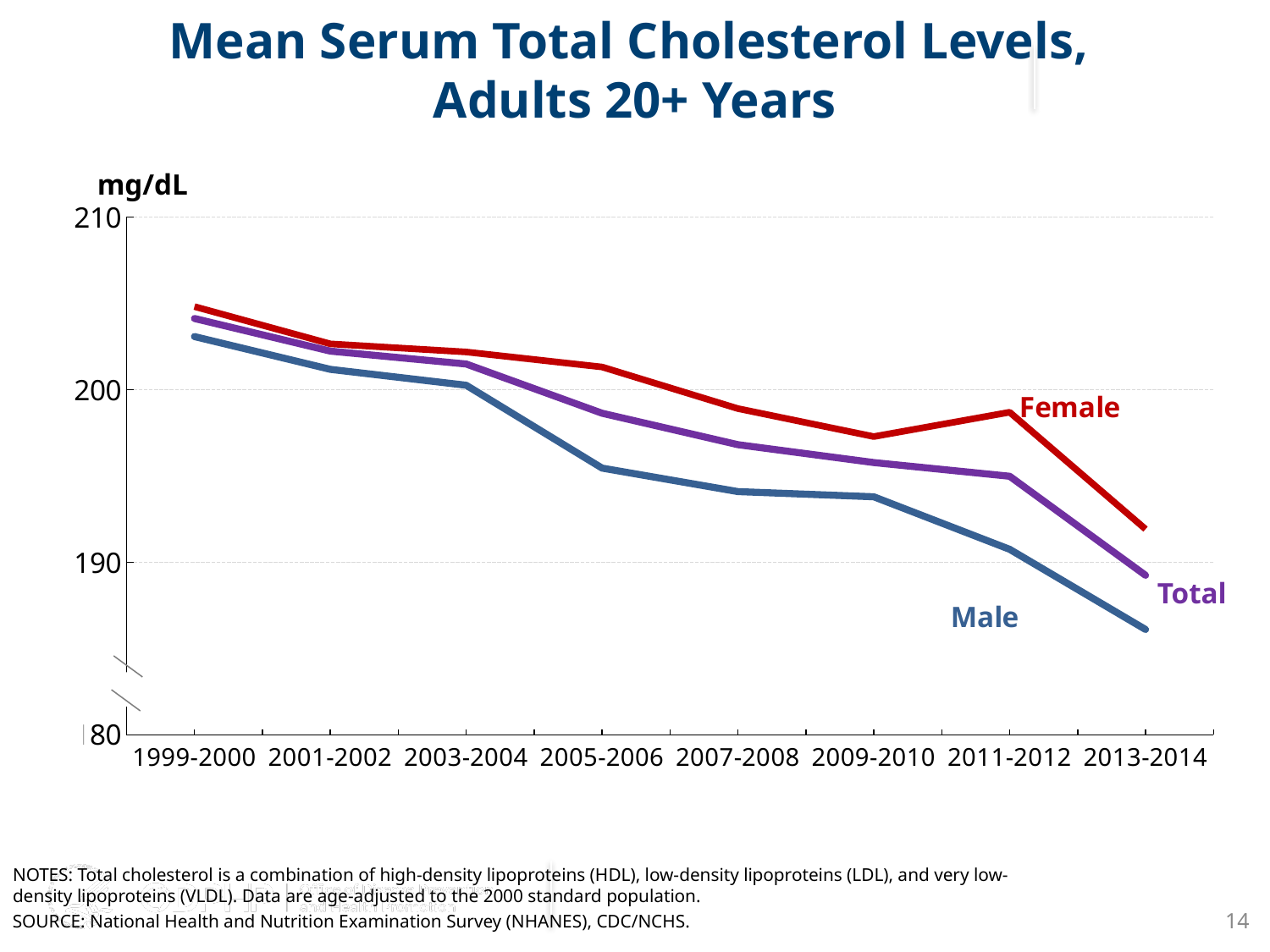
Is the value for Male in 2005-2006 greater or less than 200? less In 2013-2014, which is higher, the Female value or the Male value? Female Do the cholesterol levels generally rise or fall from 1999-2000 to 2013-2014? fall What kind of chart is shown on the slide? line chart Is the value for Total in 2009-2010 greater or less than 200? less In which survey period is the Female line at its lowest? 2013-2014 How many series (lines) are plotted on the chart? 3 Is the value for Female in 1999-2000 greater or less than 200? greater How many survey periods are shown along the x axis? 8 What unit is shown on the y axis? mg/dL